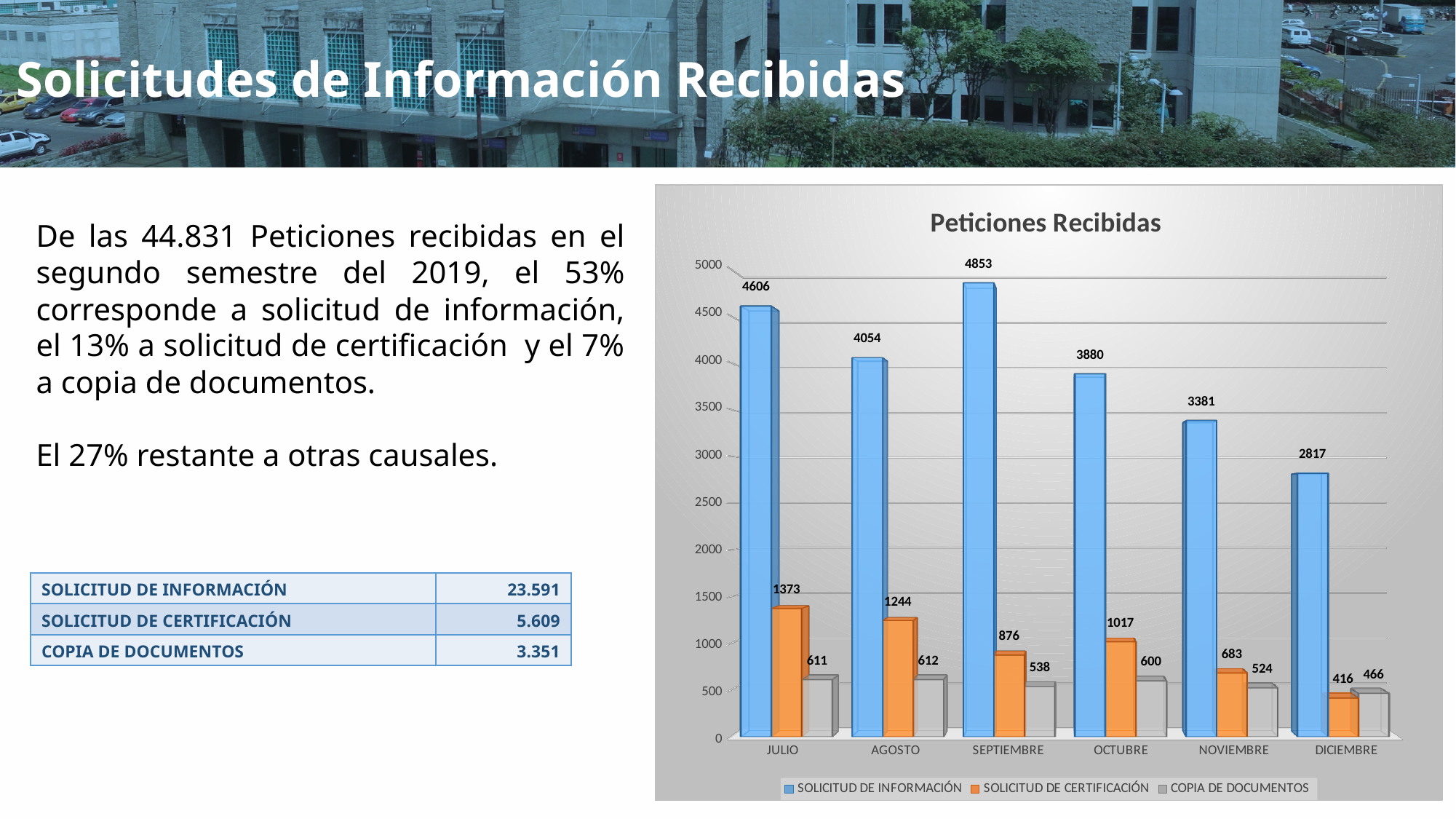
What is the difference between SOLICITUD DE INFORMACIÓN in JULIO and in DICIEMBRE? 1789 In which month is SOLICITUD DE CERTIFICACIÓN lowest? DICIEMBRE Is the value for SOLICITUD DE INFORMACIÓN in NOVIEMBRE greater or less than 3500? less What is the value for SOLICITUD DE INFORMACIÓN in SEPTIEMBRE? 4853 How many months are shown on the x axis? 6 What is the value for SOLICITUD DE CERTIFICACIÓN in OCTUBRE? 1017 What kind of chart is shown? bar chart Which is larger in DICIEMBRE: SOLICITUD DE CERTIFICACIÓN or COPIA DE DOCUMENTOS? COPIA DE DOCUMENTOS In which month is SOLICITUD DE INFORMACIÓN highest? SEPTIEMBRE What is the title of the chart? Peticiones Recibidas How many series does the legend list? 3 What is the value for COPIA DE DOCUMENTOS in DICIEMBRE? 466